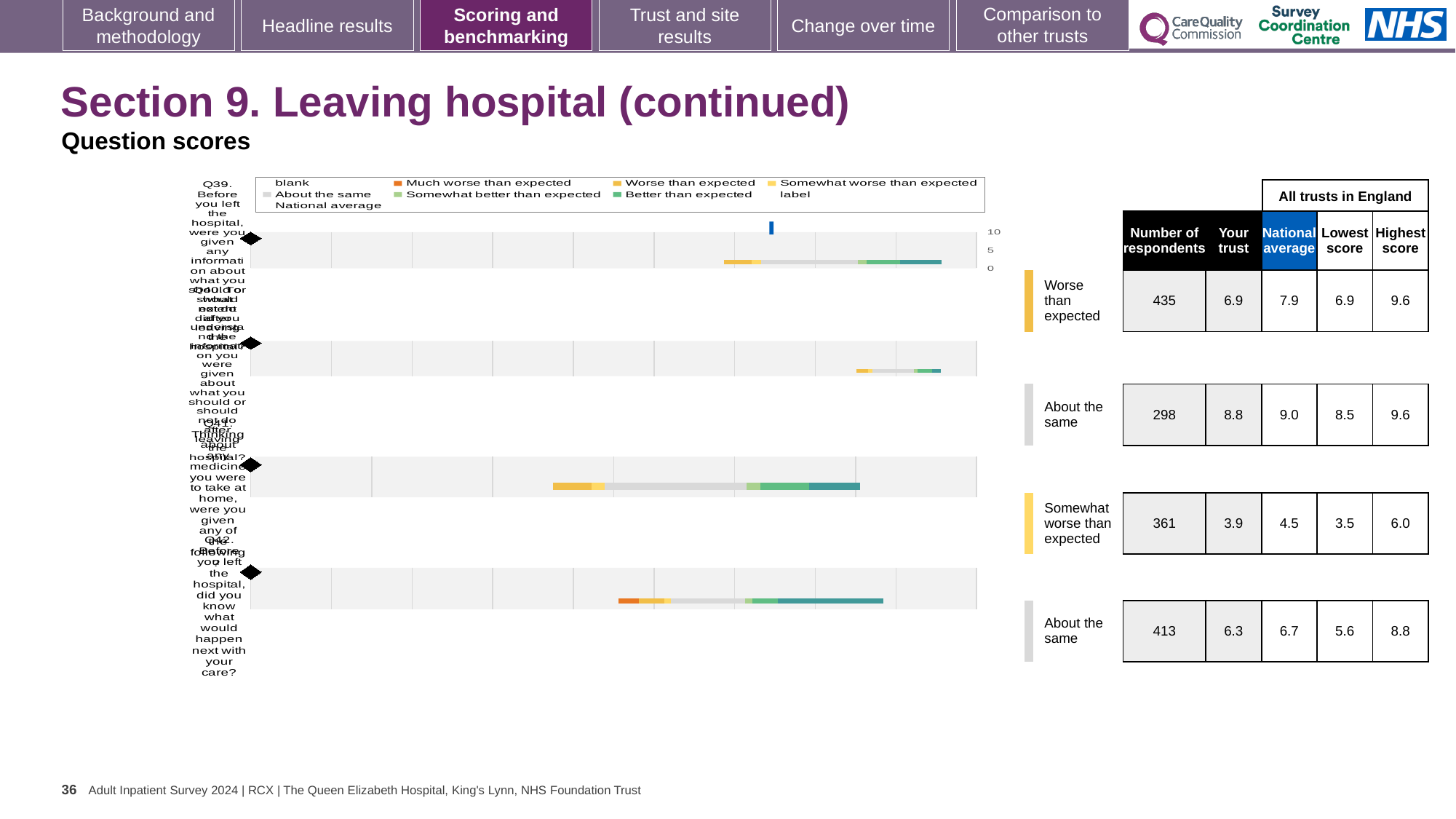
In the chart legend, what colour represents 'Much worse than expected'? orange In the table beside the chart, what is the lowest 'Your trust' score shown? 3.9 How many horizontal bars are plotted in the chart? 4 In the table beside the chart, what is the 'Your trust' score for the row labelled 'Somewhat worse than expected'? 3.9 What kind of chart is shown on the slide? bar chart In the table beside the chart, what is the difference between the national average (7.9) and the 'Your trust' score (6.9) in the first row? 1.0 In the table beside the chart, what is the number of respondents for the first row, labelled 'Worse than expected'? 435 In the table beside the chart, what is the highest 'Your trust' score shown? 8.8 In the table beside the chart, what is the highest score for the row labelled 'Somewhat worse than expected'? 6.0 In the table beside the chart, what is the lowest score for the row with 298 respondents? 8.5 In the table beside the chart, for the last row (413 respondents), which is larger: the 'Your trust' score or the national average? National average In the chart legend, what colour represents 'About the same'? grey